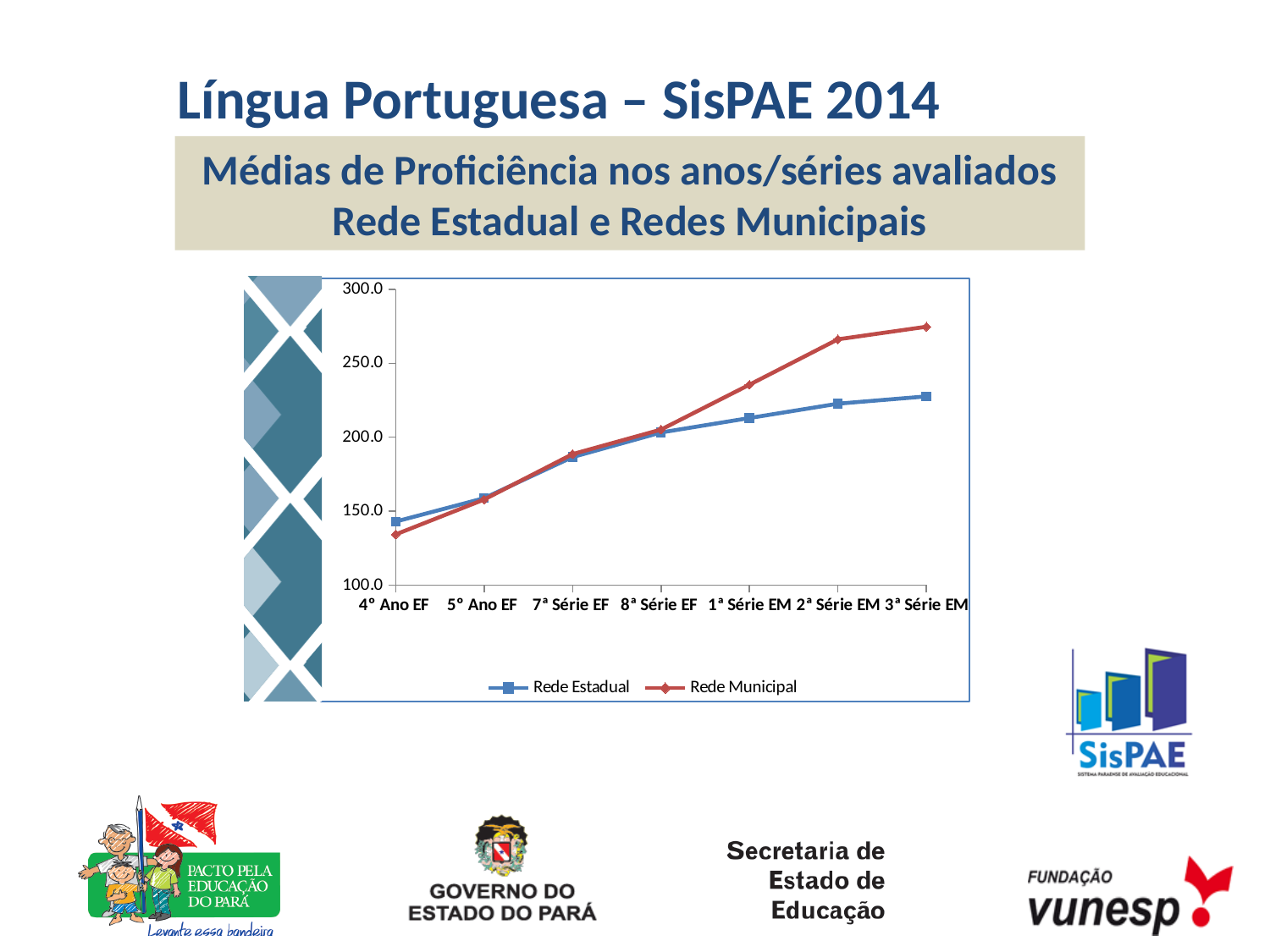
Which series is shown in red? Rede Municipal For which year/grade is the Rede Municipal value highest? 3ª Série EM At 4° Ano EF, which series has the higher value, Rede Estadual or Rede Municipal? Rede Estadual Is the Rede Municipal value for 3ª Série EM greater or less than 250.0? greater Is the Rede Estadual value for 3ª Série EM greater or less than 250.0? less Do the values for Rede Municipal rise or fall from 4° Ano EF to 3ª Série EM? rise How many years/grades are plotted along the x axis? 7 Is the Rede Municipal value for 4° Ano EF greater or less than 150.0? less At 3ª Série EM, which series has the higher value, Rede Estadual or Rede Municipal? Rede Municipal How many series does the legend list? 2 For which year/grade is the Rede Estadual value lowest? 4° Ano EF What kind of chart is shown on the slide? line chart